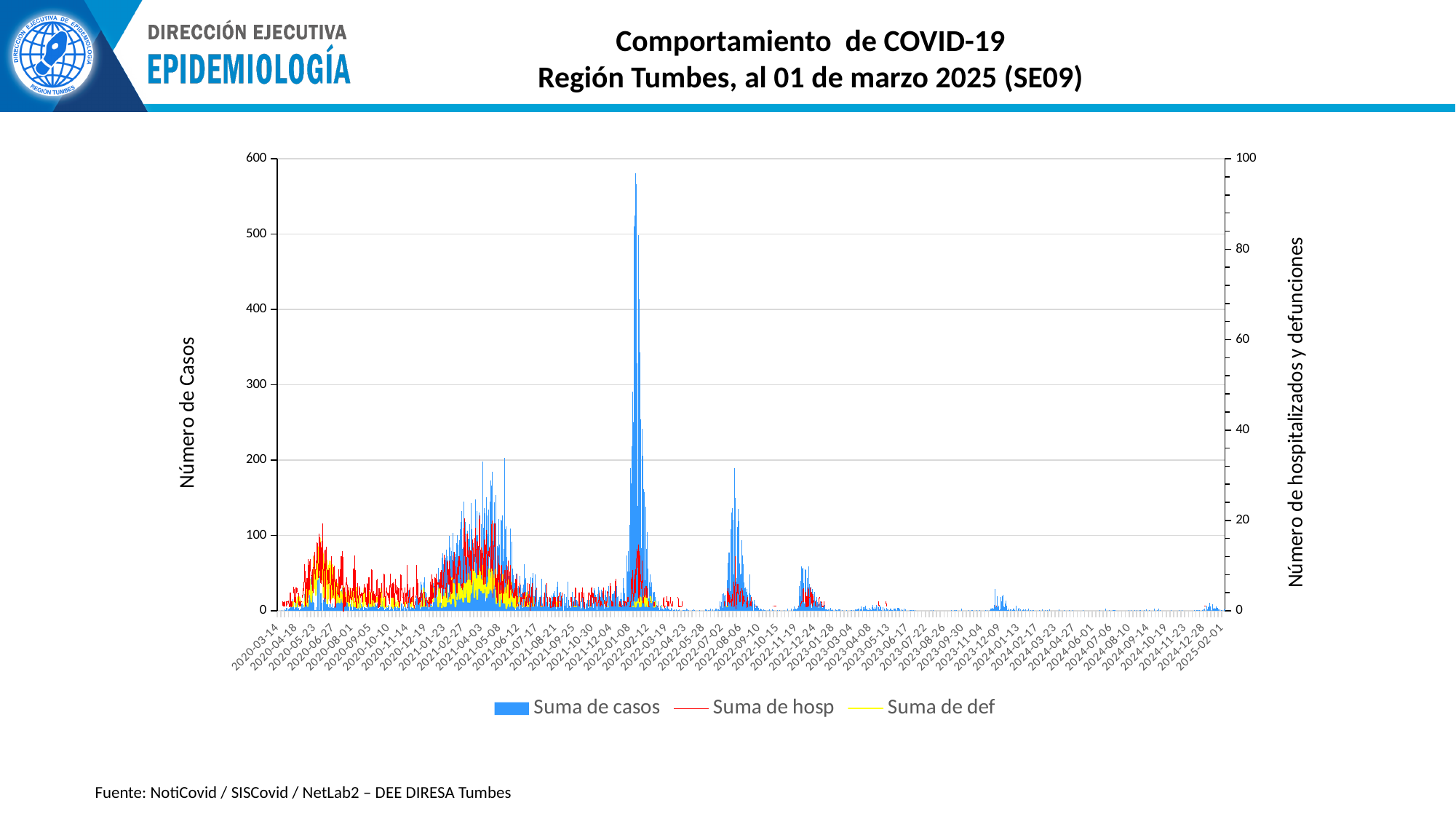
What is the title of the chart? Comportamiento de COVID-19 Región Tumbes, al 01 de marzo 2025 (SE09) Is the highest peak of Suma de casos greater or less than 400 on the left axis? greater Which series is shown in blue in the legend? Suma de casos In which year does the tallest peak of Suma de casos occur? 2022 What kind of chart is this? Combined bar and line chart Which is larger: the peak of Suma de casos in early 2022 or the peak of Suma de casos in mid-2022? The peak in early 2022 Is the value of Suma de casos around 2024-06-01 greater or less than 100 on the left axis? less What is the maximum value shown on the left vertical axis? 600 How many series does the legend list? 3 What is the maximum value shown on the right vertical axis? 100 Is the peak of Suma de casos around 2022-08-06 greater or less than 300 on the left axis? less